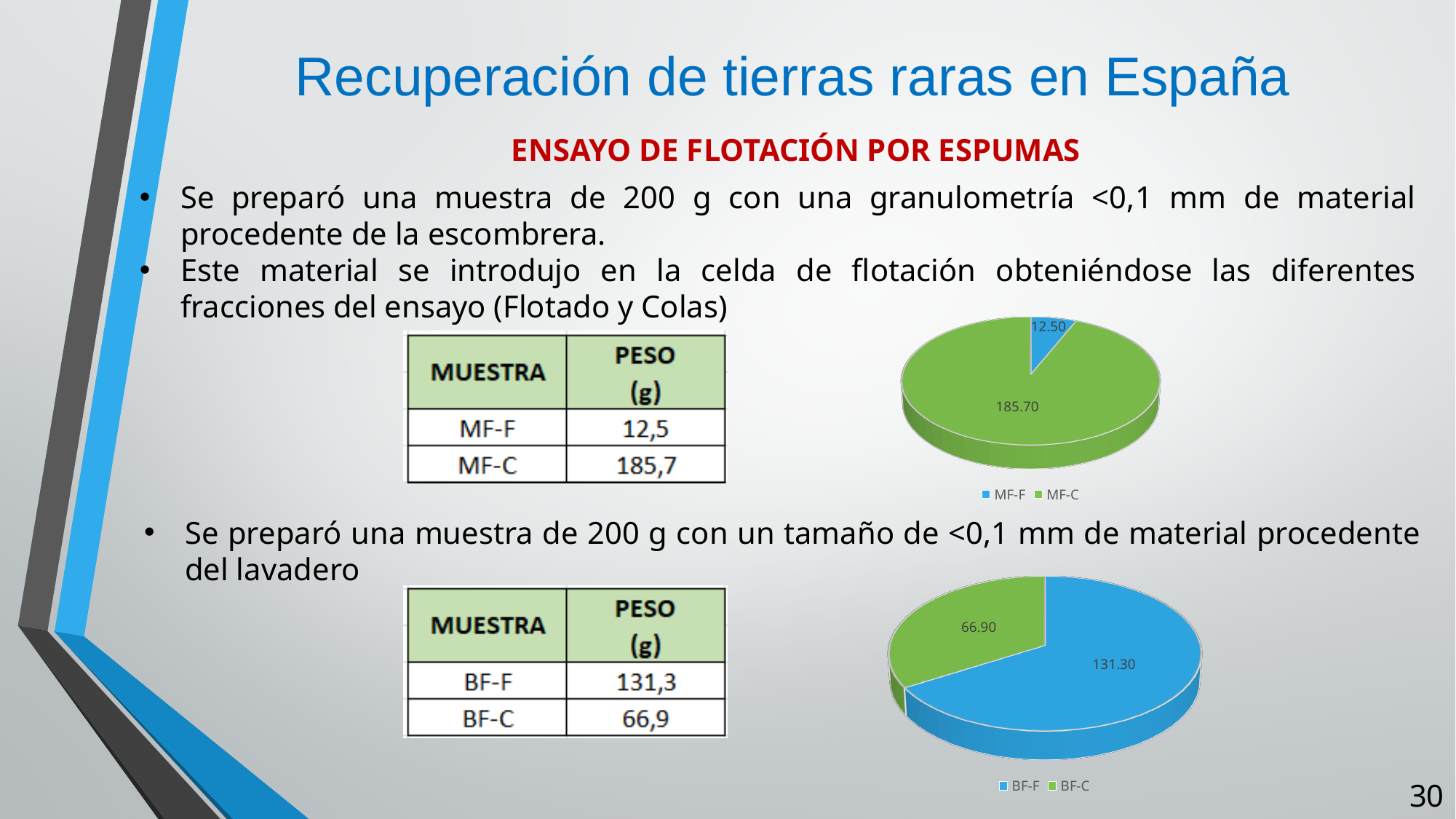
How many slices does the top pie chart have? 2 In the bottom pie chart, which category has the smallest slice? BF-C In the bottom pie chart, which is larger, BF-F or BF-C? BF-F In the bottom pie chart, what is the difference between the BF-F and BF-C values? 64.40 In the bottom pie chart, what is the value of the BF-F slice? 131.30 In the top pie chart, what is the value of the MF-F slice? 12.50 In the top pie chart, what is the difference between the MF-C and MF-F values? 173.20 In the bottom pie chart, what is the value of the BF-C slice? 66.90 In the top pie chart, what is the value of the MF-C slice? 185.70 In the top pie chart, which category has the largest slice? MF-C What type of chart is the bottom chart on the slide? Pie chart In the bottom pie chart, what colour is the BF-C slice? Green